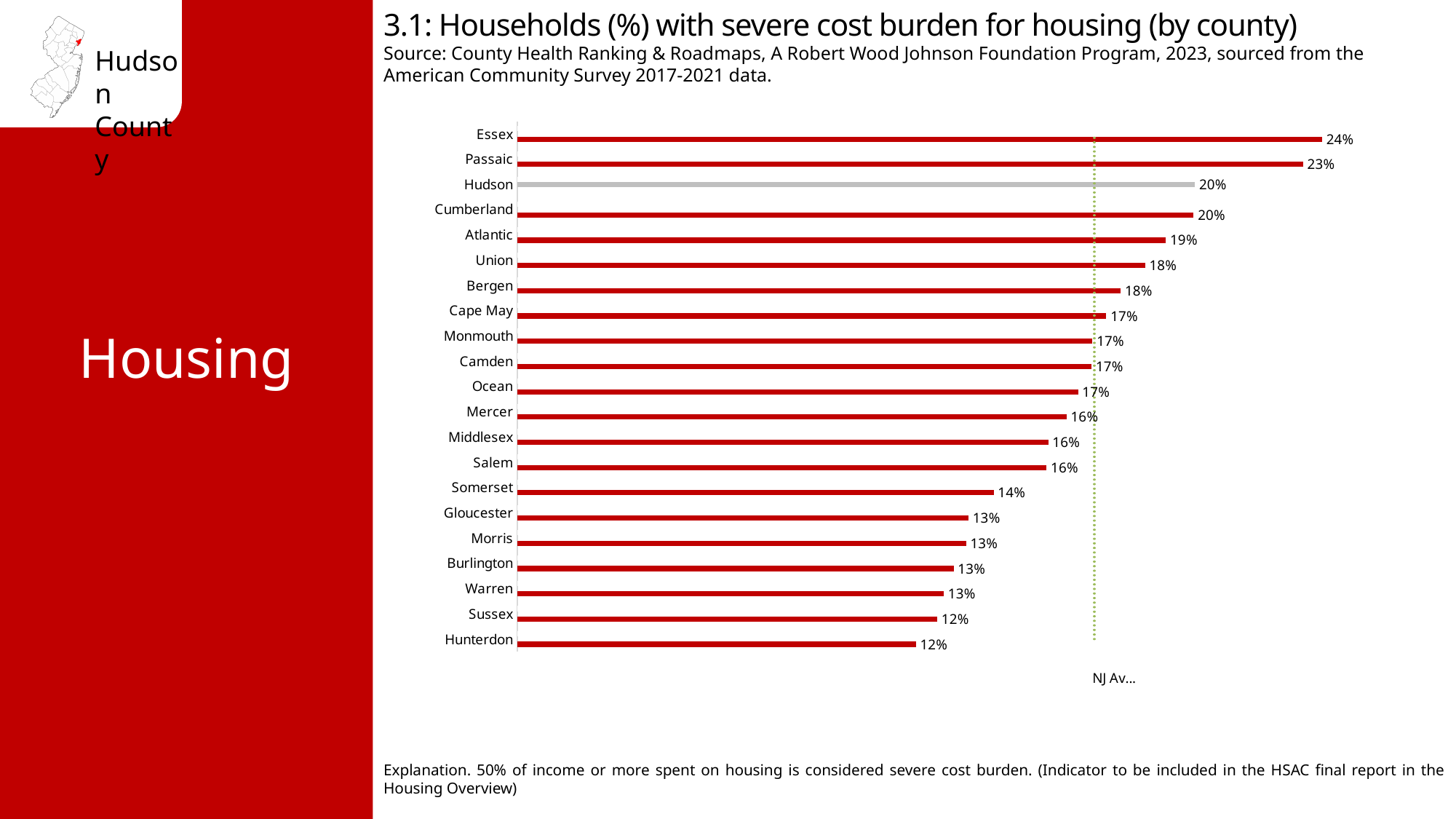
Which county's bar is shown in grey instead of red? Hudson What is the value for Essex? 24% What is the difference between the values for Passaic and Hudson? 3 percentage points What is the value for Hunterdon? 12% Which county has the highest percentage of households with severe cost burden for housing? Essex Which has a larger value, Atlantic or Somerset? Atlantic What is the value for Somerset? 14% How many counties are shown in the chart? 21 Which has a larger value, Essex or Passaic? Essex What is the value for Hudson? 20% What is the difference between the values for Essex and Hunterdon? 12 percentage points What kind of chart is shown on the slide? Bar chart